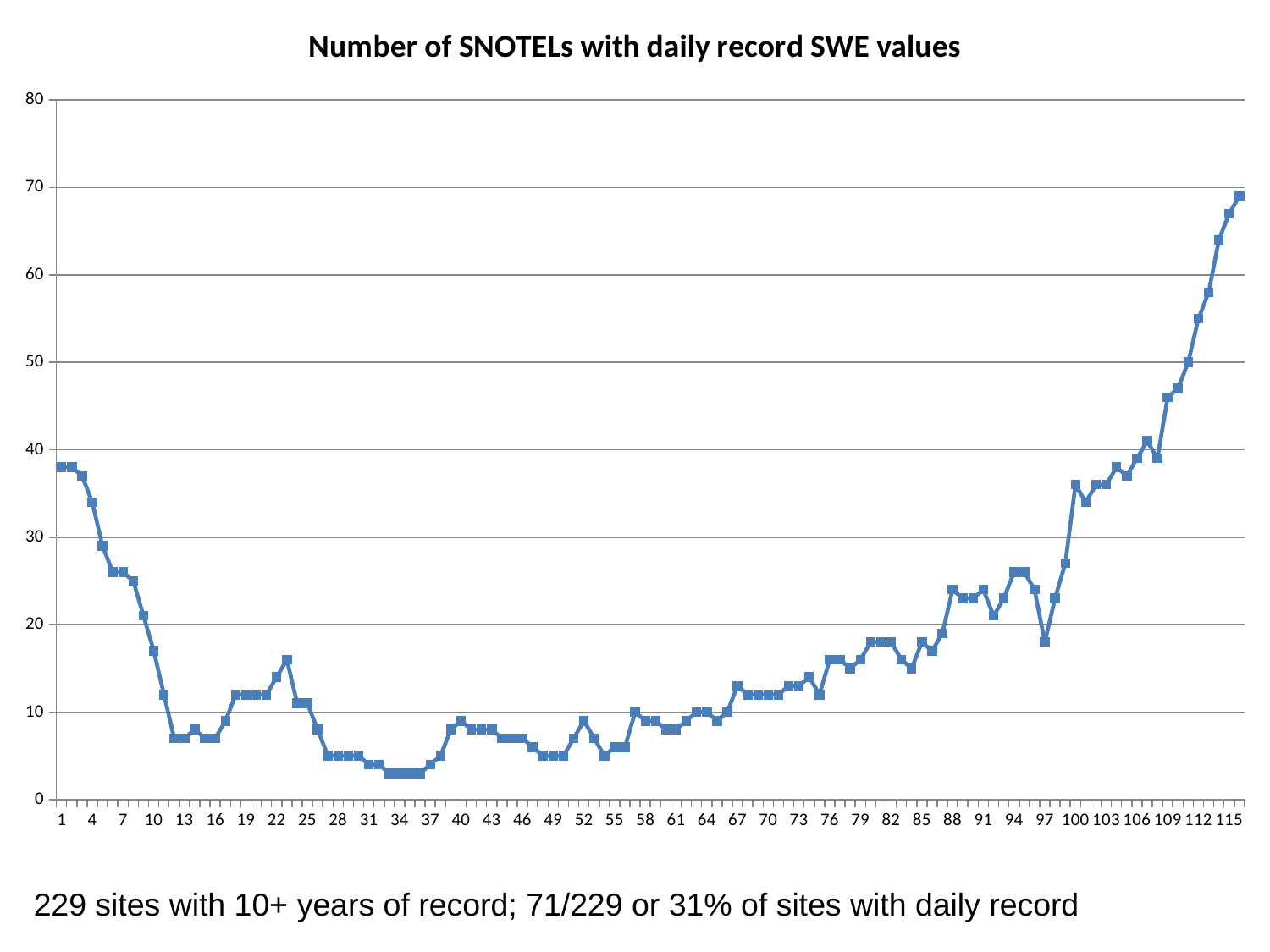
Which is larger, the value at x = 13 or the value at x = 88? x = 88 Is the value at the right end of the x axis greater or less than 60? greater Is the value at x = 34 greater or less than 10? less What is the title of the chart? Number of SNOTELs with daily record SWE values Is the value at x = 112 greater or less than 50? greater Is the lowest value on the line near x = 34 or near x = 100? near x = 34 What kind of chart is shown on the slide? line chart Is the highest value on the line at the left end or the right end of the x axis? right end Do the values rise or fall along the x axis from x = 1 to x = 34? fall